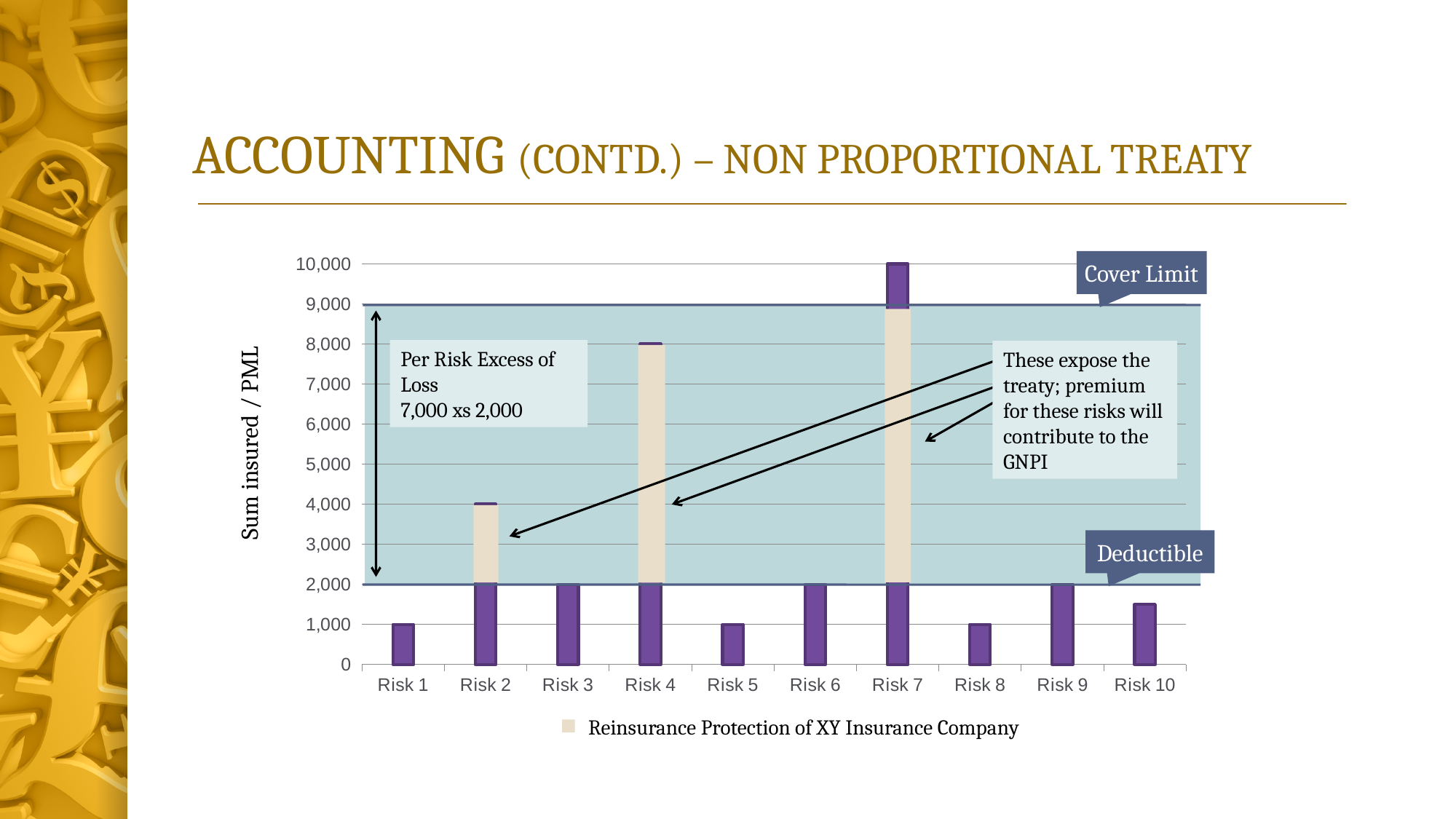
What is the sum insured / PML for Risk 2? 4,000 What kind of chart is shown on the slide? bar chart What is the sum insured / PML for Risk 7? 10,000 Is the value for Risk 10 greater or less than 2,000? less Which is larger, the value for Risk 4 or the value for Risk 2? Risk 4 How many risks (categories) are plotted on the x axis? 10 What is the title of the y axis? Sum insured / PML What entry does the legend list? Reinsurance Protection of XY Insurance Company What is the sum insured / PML for Risk 4? 8,000 What is the difference between the values for Risk 7 and Risk 4? 2,000 Which risk has the highest sum insured / PML? Risk 7 Is the value for Risk 9 greater or less than 1,000? greater